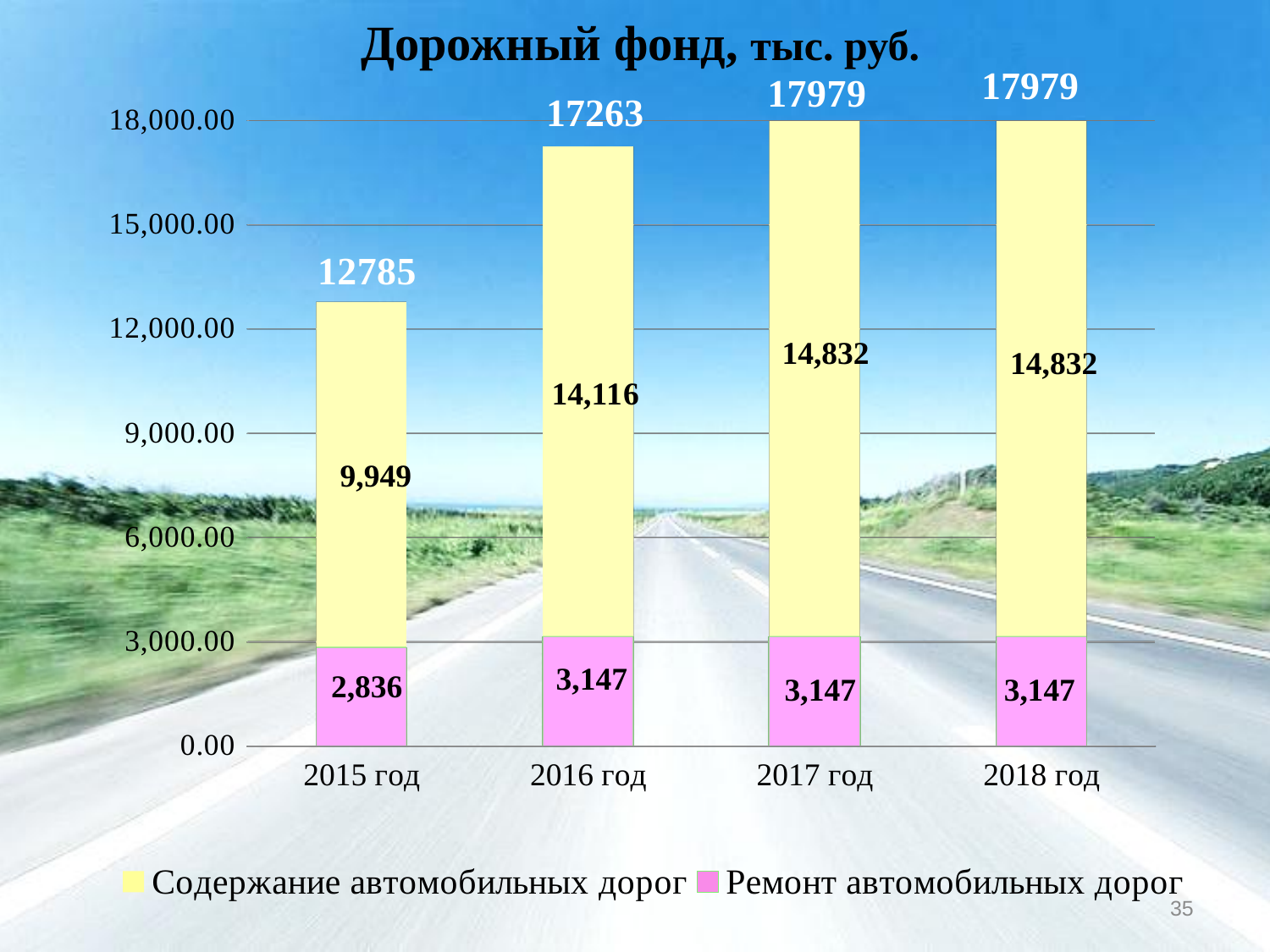
Which is larger: Ремонт автомобильных дорог in 2015 год or in 2017 год? 2017 год What kind of chart is shown on the slide? stacked bar chart How many series does the legend list? 2 What is the total of the stacked bar for 2016 год? 17263 Is the total for 2015 год greater or less than 15,000.00? less What is the value for Ремонт автомобильных дорог in 2016 год? 3,147 What is the value for Содержание автомобильных дорог in 2018 год? 14,832 Which colour represents Ремонт автомобильных дорог in the legend? pink What is the value for Содержание автомобильных дорог in 2015 год? 9,949 Which year has the lowest total Дорожный фонд? 2015 год How many years are shown on the x axis? 4 What is the difference between Содержание автомобильных дорог in 2016 год and in 2015 год? 4,167